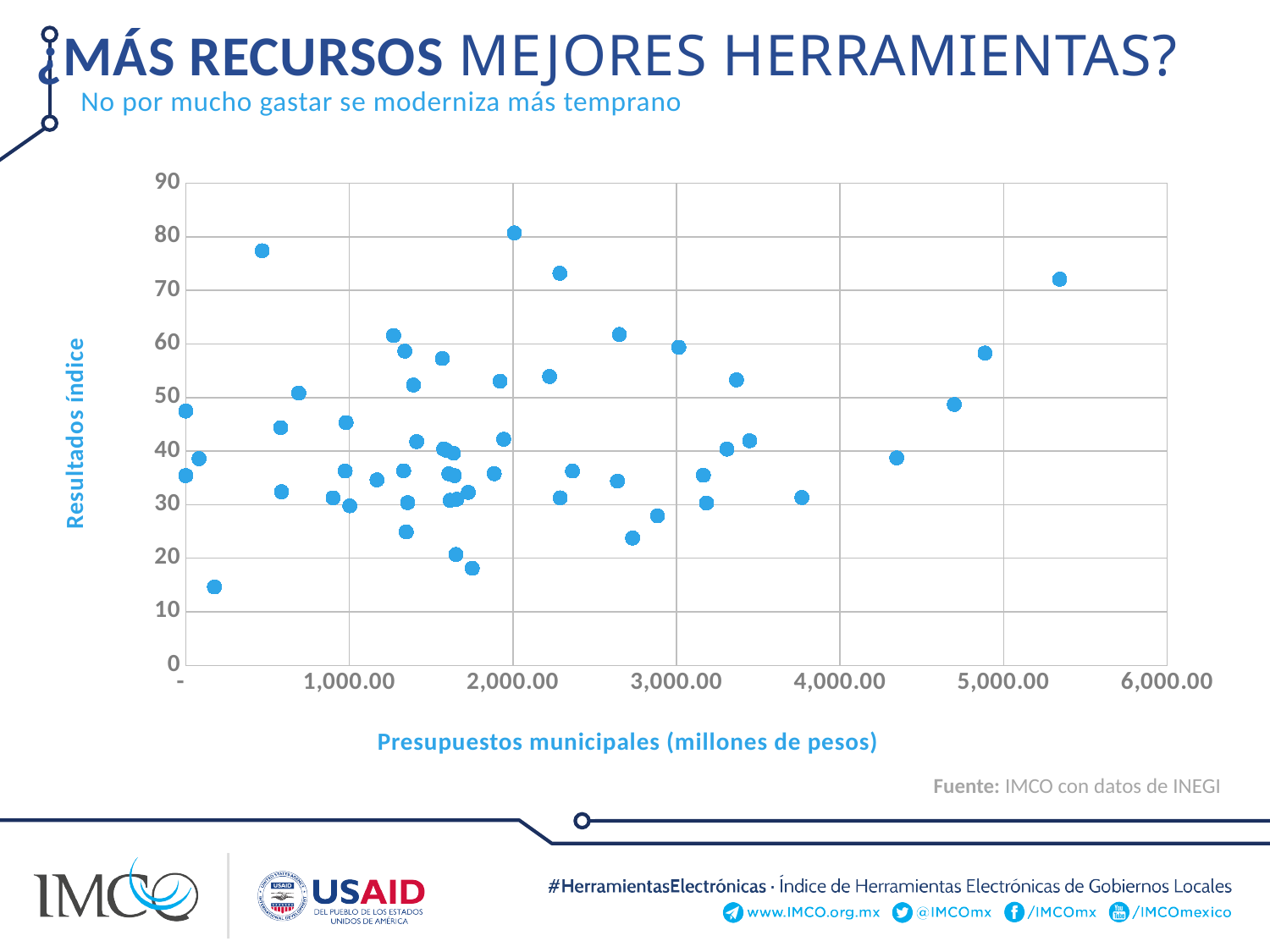
What is the highest value shown on the horizontal axis of the chart? 6,000.00 What is the title of the horizontal axis of the chart? Presupuestos municipales (millones de pesos) What kind of chart is shown on the slide? scatter plot Is the index value of the highest point in the chart greater or less than 70? greater Is the index value of the point with the largest budget greater or less than the index value of the highest point in the chart? less Is the index value of the rightmost point in the chart greater or less than 60? greater What is the highest value shown on the vertical axis of the chart? 90 What is the title of the vertical axis of the chart? Resultados índice How many points in the chart have a budget greater than 4,000.00 million pesos? 4 How many points in the chart have an index value above 70? 4 Is the budget (x value) of the rightmost point in the chart greater or less than 5,000.00? greater